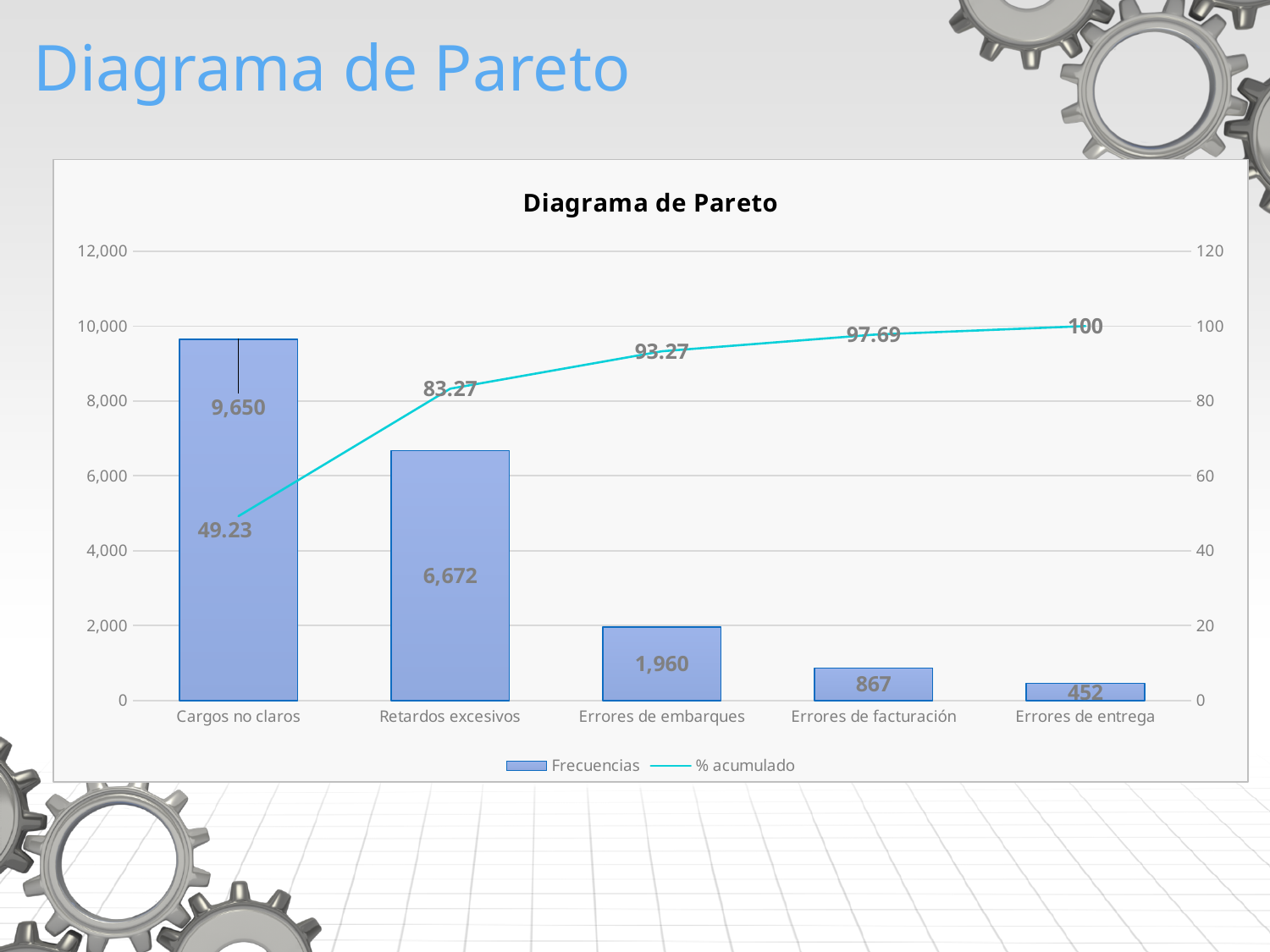
What is the % acumulado value at Retardos excesivos? 83.27 How many series does the legend list? 2 Which has a larger Frecuencias value, Errores de embarques or Errores de facturación? Errores de embarques Which category has the lowest Frecuencias value? Errores de entrega What is the difference between the Frecuencias values for Cargos no claros and Retardos excesivos? 2,978 Which category has the highest Frecuencias value? Cargos no claros What is the Frecuencias value for Cargos no claros? 9,650 What is the Frecuencias value for Errores de facturación? 867 What is the title of the chart? Diagrama de Pareto What is the % acumulado value at Errores de entrega? 100 How many categories are shown on the x axis? 5 Does the % acumulado line rise or fall from left to right? rise